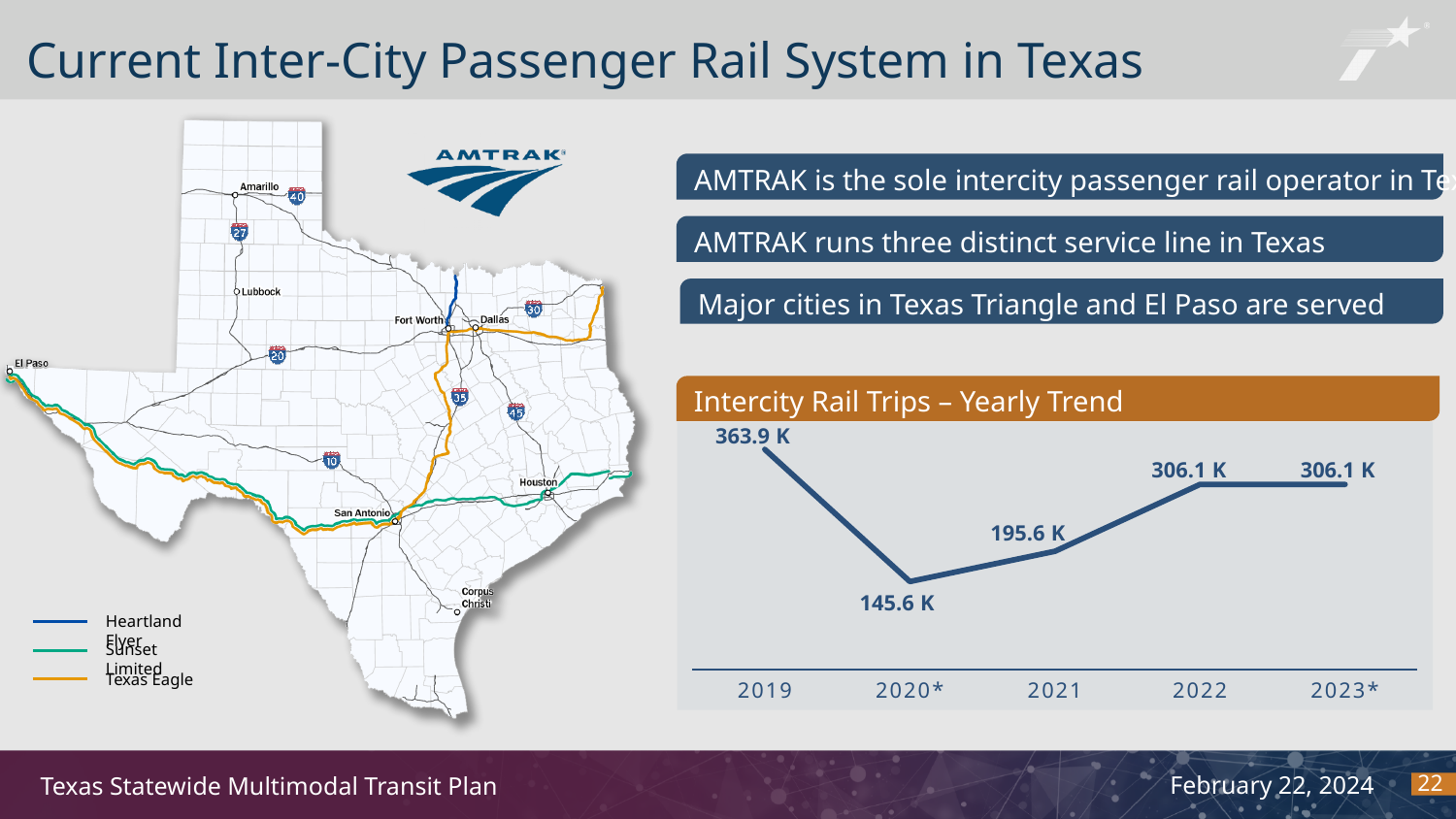
In the Intercity Rail Trips – Yearly Trend chart, what is the value for 2021? 195.6 K What kind of chart is the Intercity Rail Trips – Yearly Trend chart? line chart In the Intercity Rail Trips – Yearly Trend chart, what is the value for 2022? 306.1 K How many years are plotted in the Intercity Rail Trips – Yearly Trend chart? 5 In the Intercity Rail Trips – Yearly Trend chart, which is larger, the value for 2021 or the value for 2020*? 2021 In the Intercity Rail Trips – Yearly Trend chart, what is the value for 2020*? 145.6 K In the Intercity Rail Trips – Yearly Trend chart, do the values rise or fall from 2020* to 2022? rise In the Intercity Rail Trips – Yearly Trend chart, what is the difference between the 2022 and 2021 values? 110.5 K In the Intercity Rail Trips – Yearly Trend chart, which year has the lowest value? 2020* In the Intercity Rail Trips – Yearly Trend chart, which year has the highest value? 2019 In the Intercity Rail Trips – Yearly Trend chart, what is the value for 2019? 363.9 K In the Intercity Rail Trips – Yearly Trend chart, what is the difference between the 2019 and 2020* values? 218.3 K